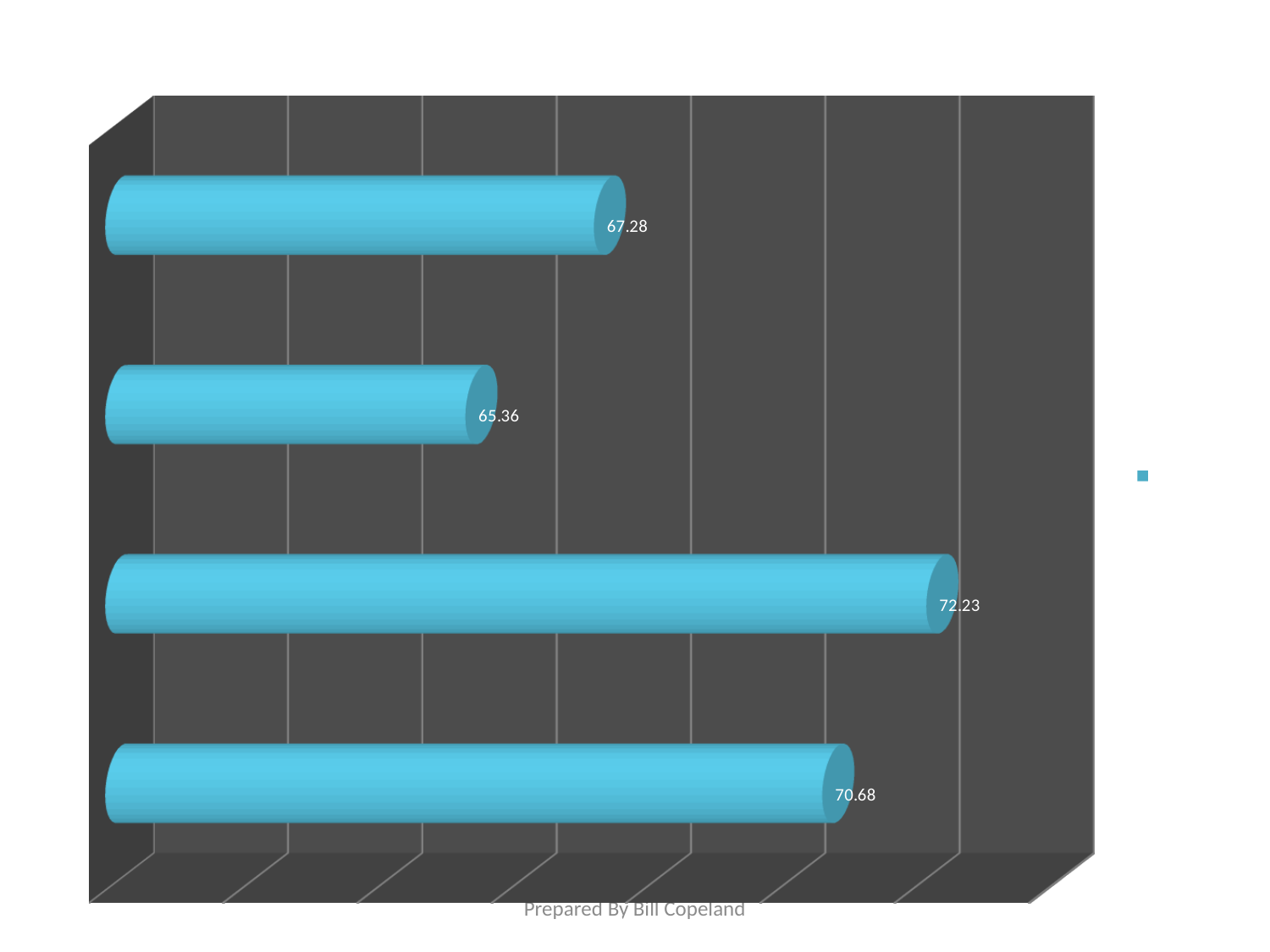
What is the value shown on the second bar from the top? 65.36 What is the difference between the highest value (72.23) and the lowest value (65.36)? 6.87 How many series does the legend list? 1 What is the value shown on the third bar from the top? 72.23 What kind of chart is shown on the slide? Bar chart Which bar has the highest value? The third bar from the top (72.23) How many bars are plotted in the chart? 4 Which bar has the lowest value? The second bar from the top (65.36) What is the difference between the bottom bar (70.68) and the top bar (67.28)? 3.40 What is the value shown on the top bar of the chart? 67.28 Which is larger, the value of the top bar or the value of the bottom bar? The bottom bar (70.68) What is the value shown on the bottom bar of the chart? 70.68